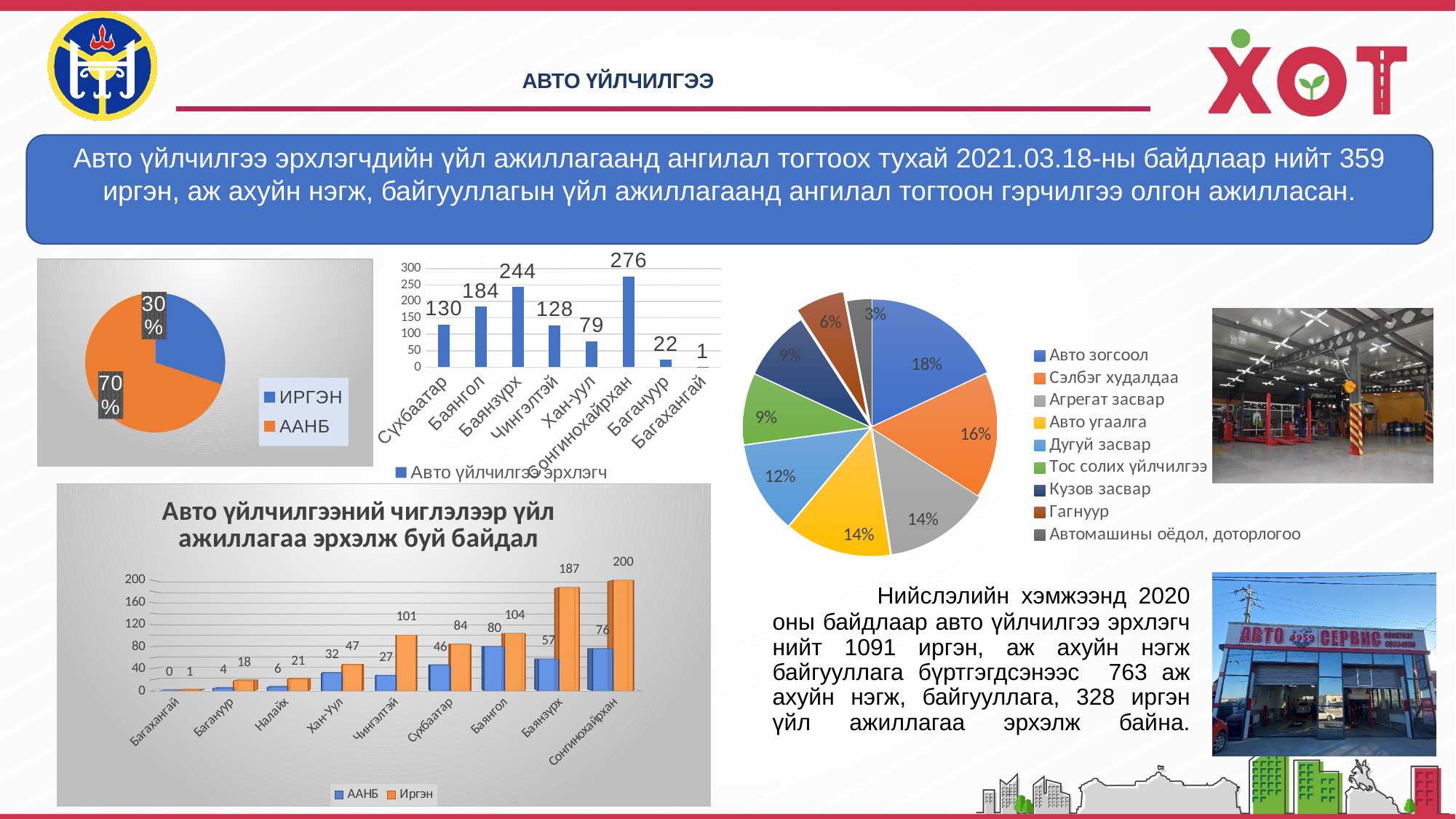
What kind of chart is the one titled 'Авто үйлчилгээний чиглэлээр үйл ажиллагаа эрхэлж буй байдал'? Bar chart In the large pie chart on the right, which category has the smallest share? Автомашины оёдол, доторлогоо In the bar chart at the top centre (legend 'Авто үйлчилгээ эрхлэгч'), what is the difference between Баянзүрх and Баянгол? 60 In the bar chart at the top centre (legend 'Авто үйлчилгээ эрхлэгч'), what is the value for Сонгинохайрхан? 276 In the chart titled 'Авто үйлчилгээний чиглэлээр үйл ажиллагаа эрхэлж буй байдал', what is the Иргэн value for Баянзүрх? 187 In the bar chart at the top centre (legend 'Авто үйлчилгээ эрхлэгч'), how many districts are shown? 8 In the chart titled 'Авто үйлчилгээний чиглэлээр үйл ажиллагаа эрхэлж буй байдал', which is larger for Чингэлтэй: ААНБ or Иргэн? Иргэн In the small pie chart at the top left, what share does ААНБ have? 70% In the large pie chart on the right, what share does Авто зогсоол have? 18% In the chart titled 'Авто үйлчилгээний чиглэлээр үйл ажиллагаа эрхэлж буй байдал', how many series does the legend list? 2 In the bar chart at the top centre (legend 'Авто үйлчилгээ эрхлэгч'), which district has the lowest value? Багахангай In the large pie chart on the right, how many categories does the legend list? 9